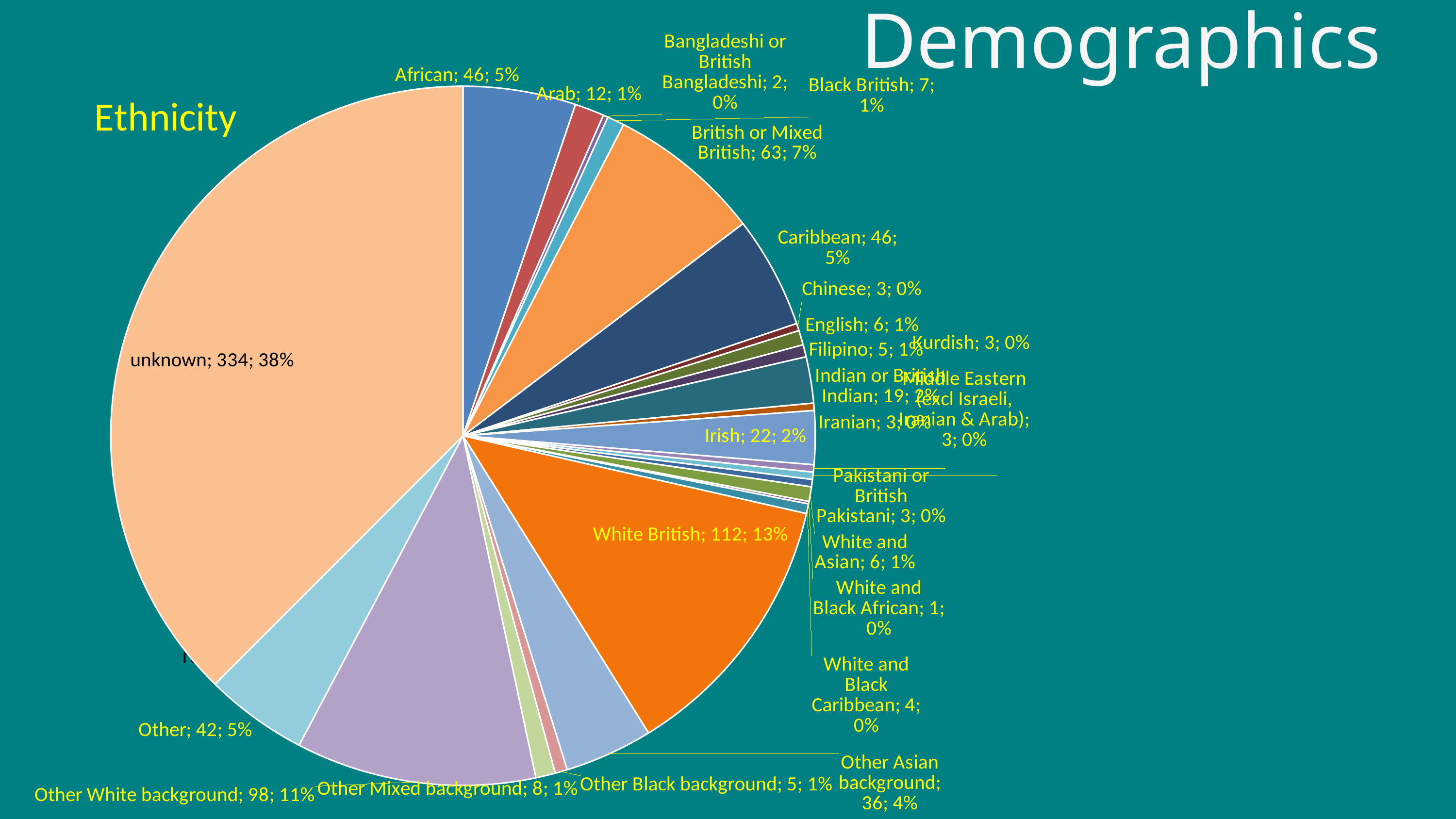
Which is larger, the value for African or the value for Other? African What is the value for Irish? 22 What share of the pie does the unknown slice represent? 38% What is the difference between the values for White British and Other White background? 14 What is the value for British or Mixed British? 63 What is the difference between the values for Caribbean and Indian or British Indian? 27 What type of chart is shown on the slide? pie chart What share of the pie does Other Asian background represent? 4% What is the value for Other White background? 98 What is the title of the chart? Ethnicity Which category has the largest slice? unknown What is the value for White British? 112